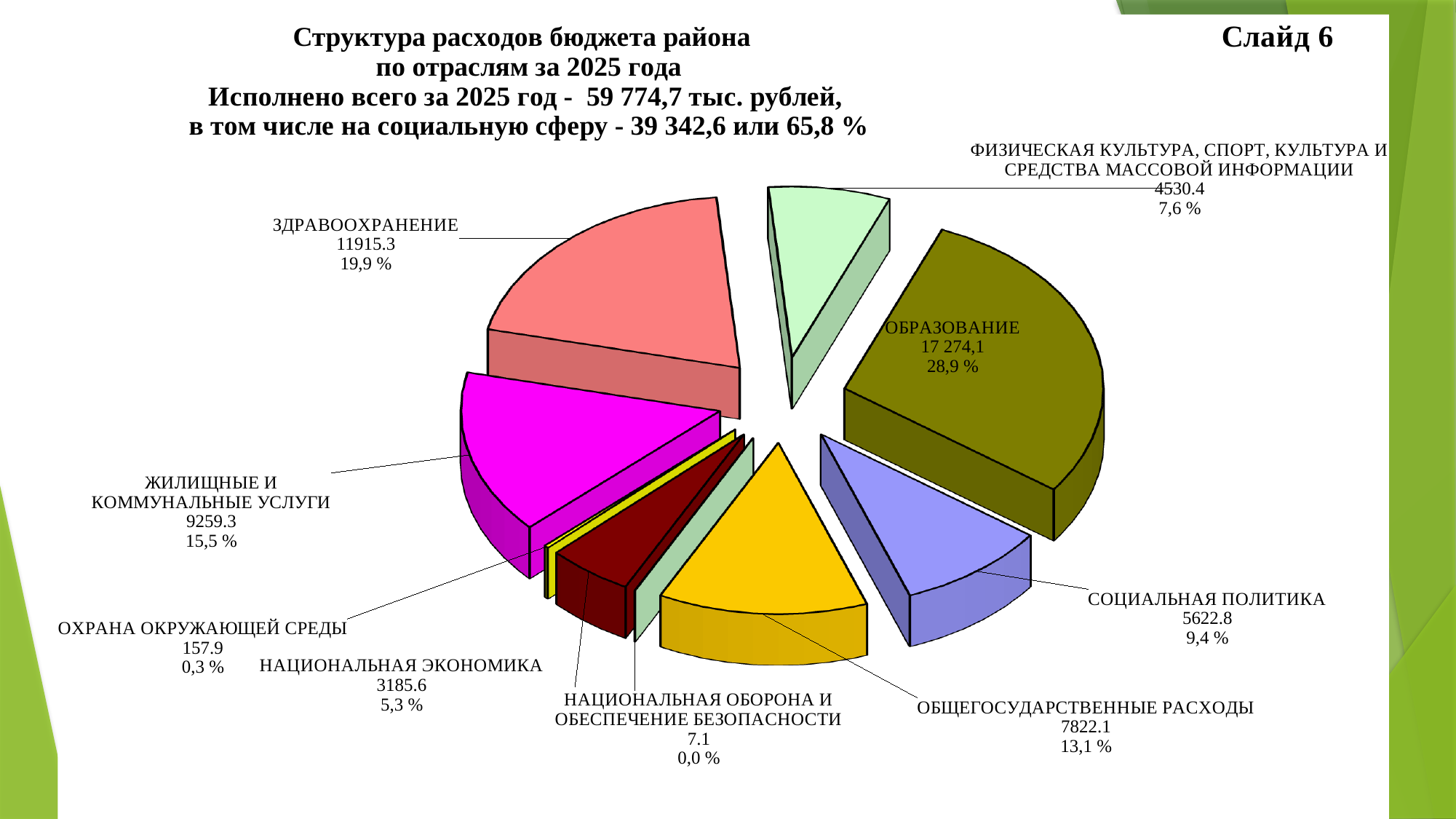
What is the value shown for ОХРАНА ОКРУЖАЮЩЕЙ СРЕДЫ? 157.9 Which category has the smallest slice of the pie? НАЦИОНАЛЬНАЯ ОБОРОНА И ОБЕСПЕЧЕНИЕ БЕЗОПАСНОСТИ By how many percentage points does the share of ОБРАЗОВАНИЕ exceed the share of ЗДРАВООХРАНЕНИЕ? 9,0 % What is the value shown for ОБРАЗОВАНИЕ? 17 274,1 What percentage share is shown for ЖИЛИЩНЫЕ И КОММУНАЛЬНЫЕ УСЛУГИ? 15,5 % Which category has the largest slice of the pie? ОБРАЗОВАНИЕ How many categories (slices) does the pie chart show? 9 What percentage share is shown for ОБЩЕГОСУДАРСТВЕННЫЕ РАСХОДЫ? 13,1 % What kind of chart is shown on the slide? Pie chart What is the value shown for ЗДРАВООХРАНЕНИЕ? 11915.3 Which is larger: СОЦИАЛЬНАЯ ПОЛИТИКА or ОБЩЕГОСУДАРСТВЕННЫЕ РАСХОДЫ? ОБЩЕГОСУДАРСТВЕННЫЕ РАСХОДЫ What is the difference between the values for ЗДРАВООХРАНЕНИЕ and ЖИЛИЩНЫЕ И КОММУНАЛЬНЫЕ УСЛУГИ? 2656.0